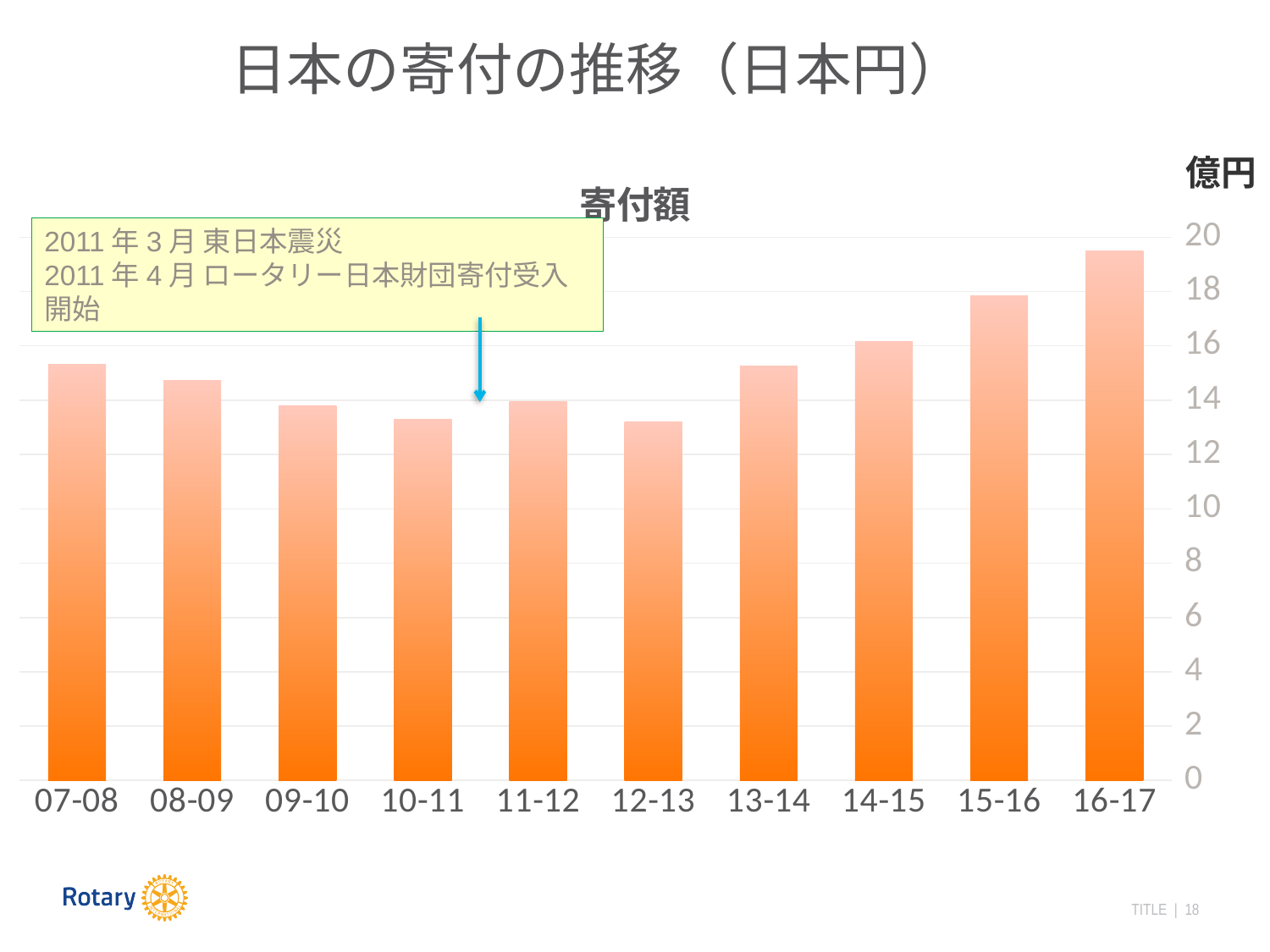
What unit is shown for the vertical axis? 億円 Which year has the highest donation amount? 16-17 Is the value for 15-16 greater or less than 16? greater What kind of chart is shown on the slide? bar chart Is the value for 10-11 greater or less than 14? less Is the value for 12-13 greater or less than 14? less Which is larger, the value for 14-15 or the value for 10-11? 14-15 What is the title of the chart? 寄付額 How many fiscal-year categories are plotted on the x axis? 10 Do the values rise or fall from 13-14 to 16-17? rise